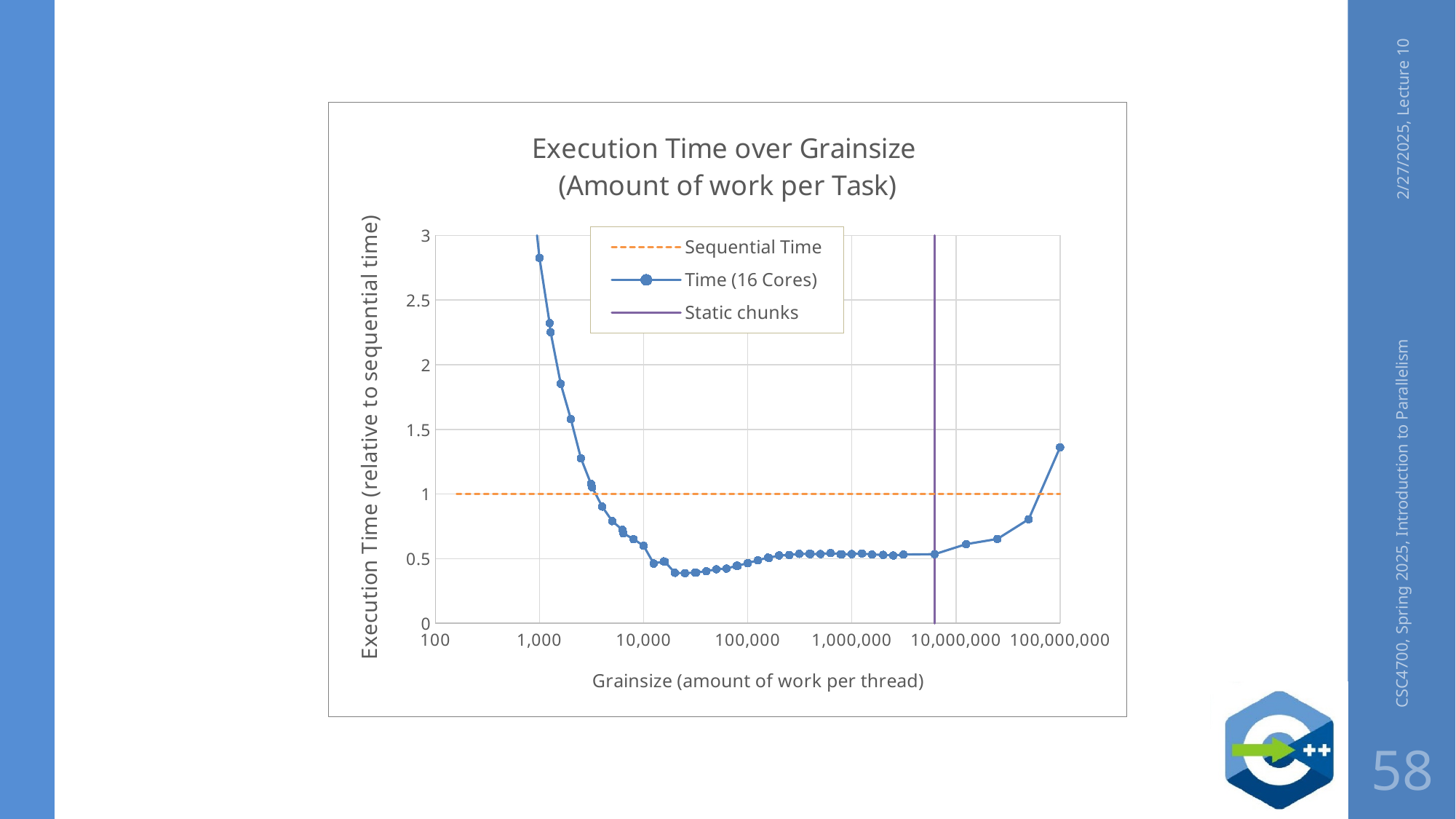
Is the Time (16 Cores) value at a grainsize of 1,000 greater or less than 2.5? greater Is the Time (16 Cores) value at a grainsize of 100,000,000 greater or less than 1? greater How many series does the legend list? 3 Is the lowest Time (16 Cores) value on the chart greater or less than 0.5? less Which is larger for Time (16 Cores): the value at a grainsize of 1,000 or at 100,000,000? 1,000 What kind of chart is shown on the slide? line chart Does the Time (16 Cores) series rise or fall as grainsize increases from 10,000,000 to 100,000,000? rise At what execution time value does the Sequential Time line sit? 1 Does the Time (16 Cores) series rise or fall as grainsize increases from 1,000 to 10,000? fall What is the title of the chart? Execution Time over Grainsize (Amount of work per Task) Which legend entry is drawn as a dashed orange line? Sequential Time